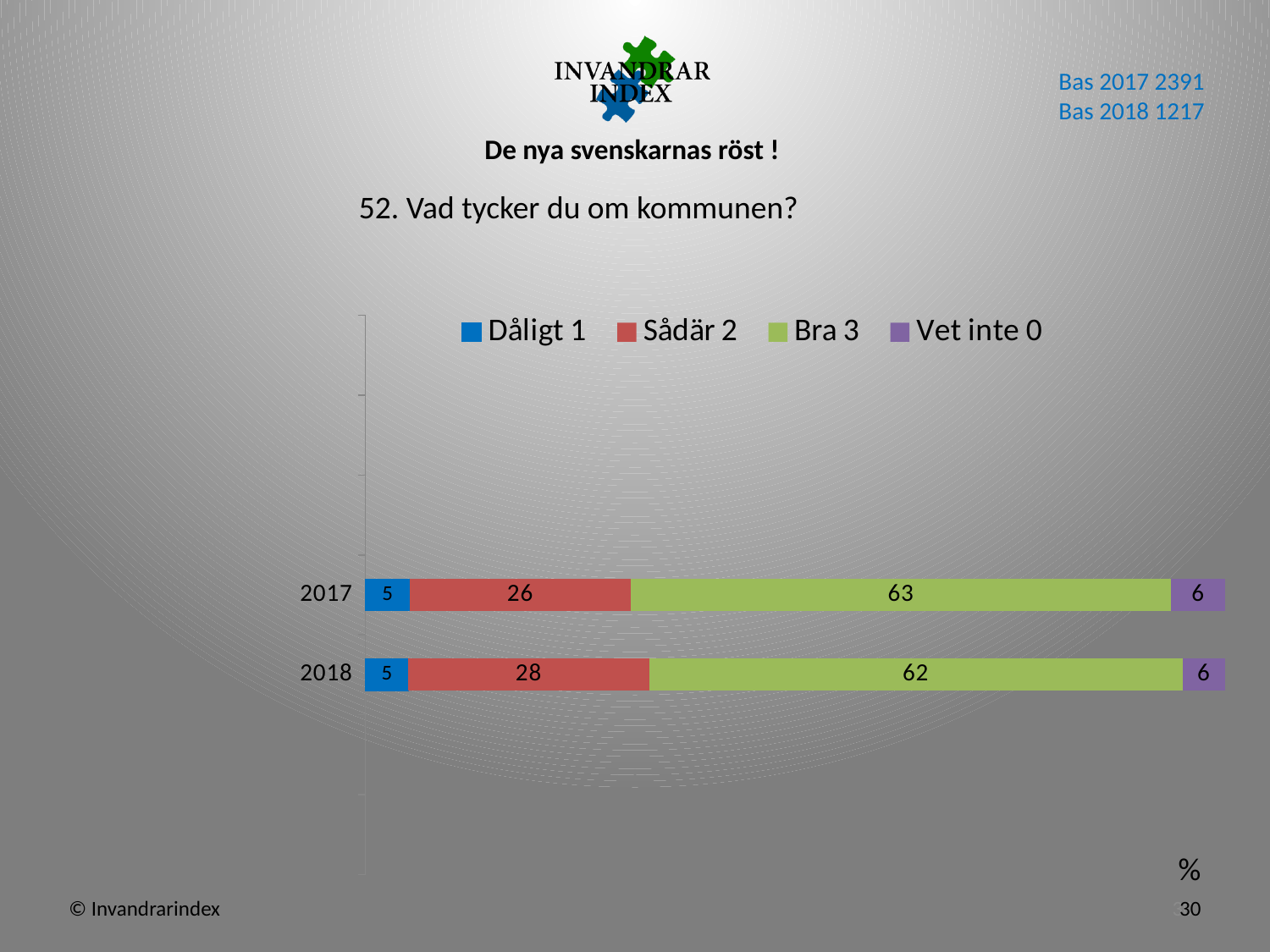
What is the difference between the Bra 3 values for 2017 and 2018? 1 Which series has the smallest value in 2017? Dåligt 1 What is the value for Vet inte 0 in 2017? 6 How many years are shown on the chart? 2 What is the value for Bra 3 in 2017? 63 How many series does the legend list? 4 What is the value for Dåligt 1 in 2018? 5 Which is larger, Sådär 2 in 2017 or Sådär 2 in 2018? Sådär 2 in 2018 What is the total of the stacked bar for 2017? 100 What is the value for Sådär 2 in 2018? 28 Which series has the largest value in 2018? Bra 3 What kind of chart is shown on the slide? Stacked bar chart